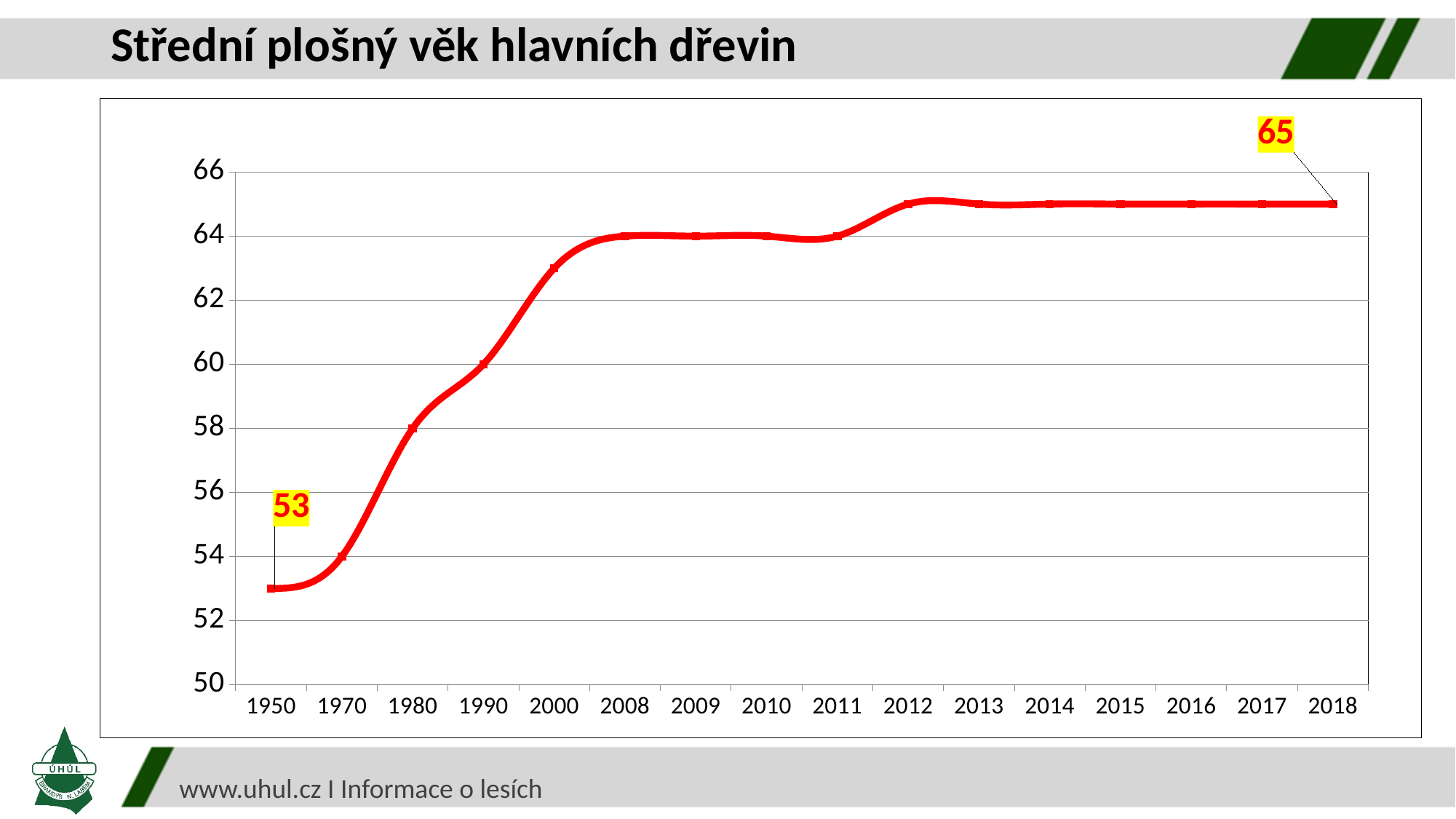
What kind of chart is this? line chart Is the value for 1970 greater or less than 56? less What is the value for 1950? 53 Is the value for 2000 greater or less than 62? greater What is the value for 2008? 64 What is the difference between the values for 2018 and 1950? 12 Which is larger, the value for 1990 or the value for 2011? 2011 What is the value for 1980? 58 What is the value for 1990? 60 Which year has the lowest value? 1950 What is the value for 2018? 65 How many years are shown on the x axis? 16